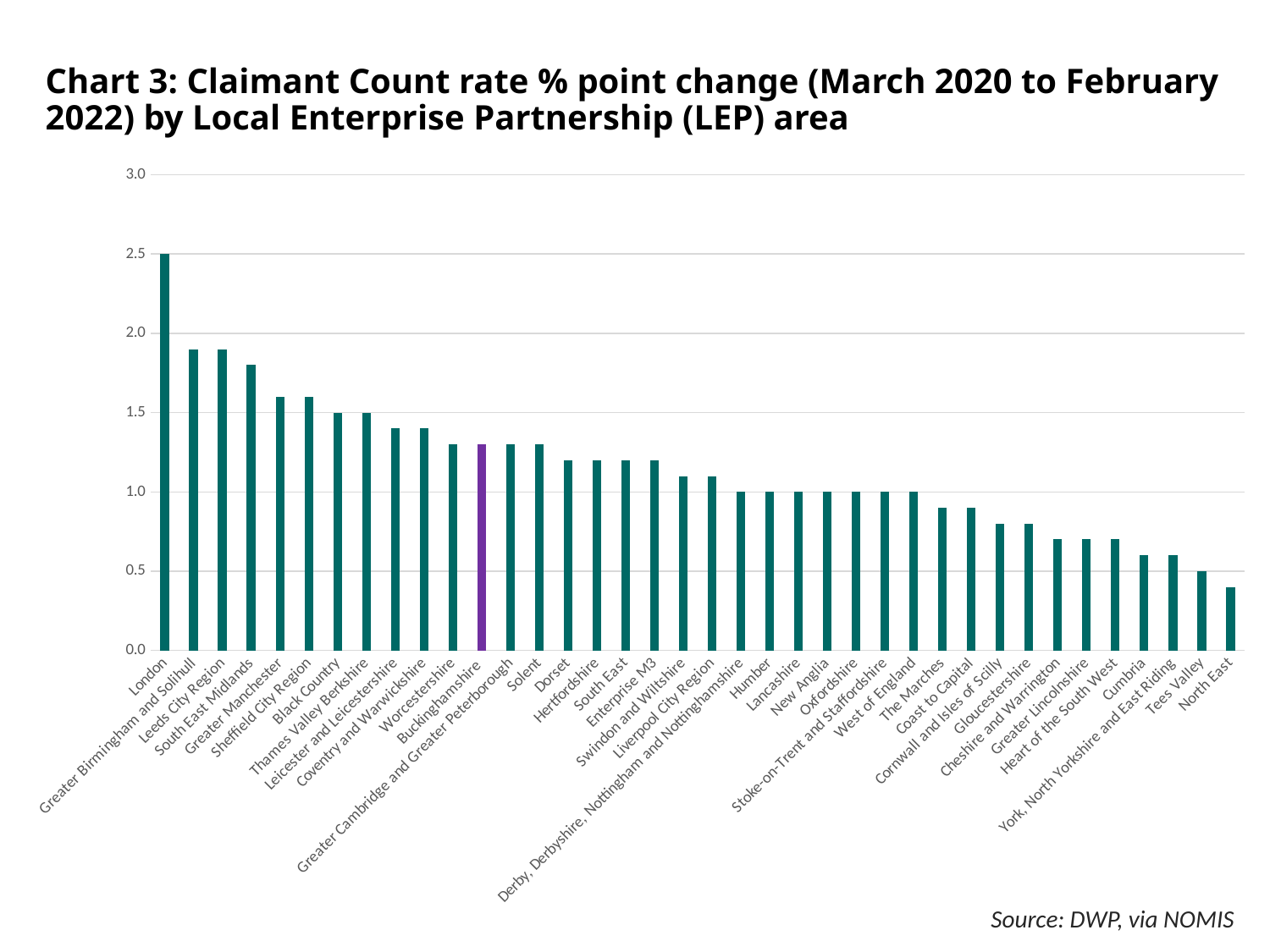
Is the value for Leeds City Region greater or less than 1.5? greater Which LEP area has the lowest claimant count rate % point change? North East Which is larger, the value for Greater Manchester or the value for Dorset? Greater Manchester What is the value for Humber? 1.0 What is the value for Tees Valley? 0.5 Which LEP area's bar is coloured purple rather than green? Buckinghamshire Do the values rise or fall moving from left to right along the x axis? fall What kind of chart is this? bar chart How many LEP areas are shown on the chart? 38 Is the value for Cumbria greater or less than 1.0? less What is the value for London? 2.5 Which LEP area has the highest claimant count rate % point change? London